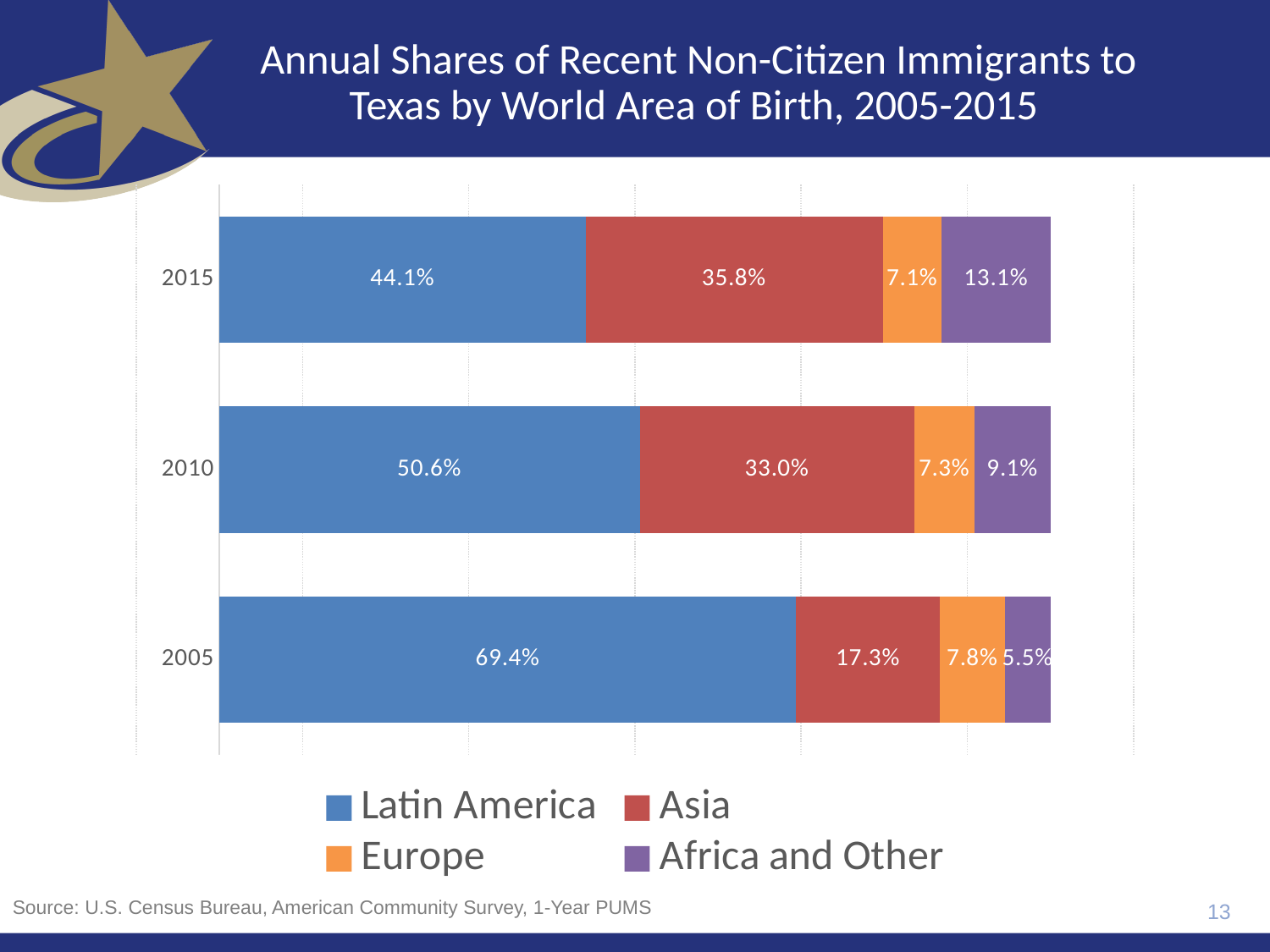
What is the difference between the Latin America share in 2005 and in 2015? 25.3% In which year is the Latin America share highest? 2005 How many series does the legend list? 4 Does the Asia share rise or fall from 2005 to 2015? Rise What is the Africa and Other share for 2015? 13.1% What kind of chart is shown? Stacked bar chart What is the Europe share for 2010? 7.3% In which year is the Africa and Other share lowest? 2005 Which is larger in 2010: the Asia share or the Latin America share? Latin America What is the Asia share for 2005? 17.3% How many years are shown on the chart? 3 What is the Latin America share for 2015? 44.1%